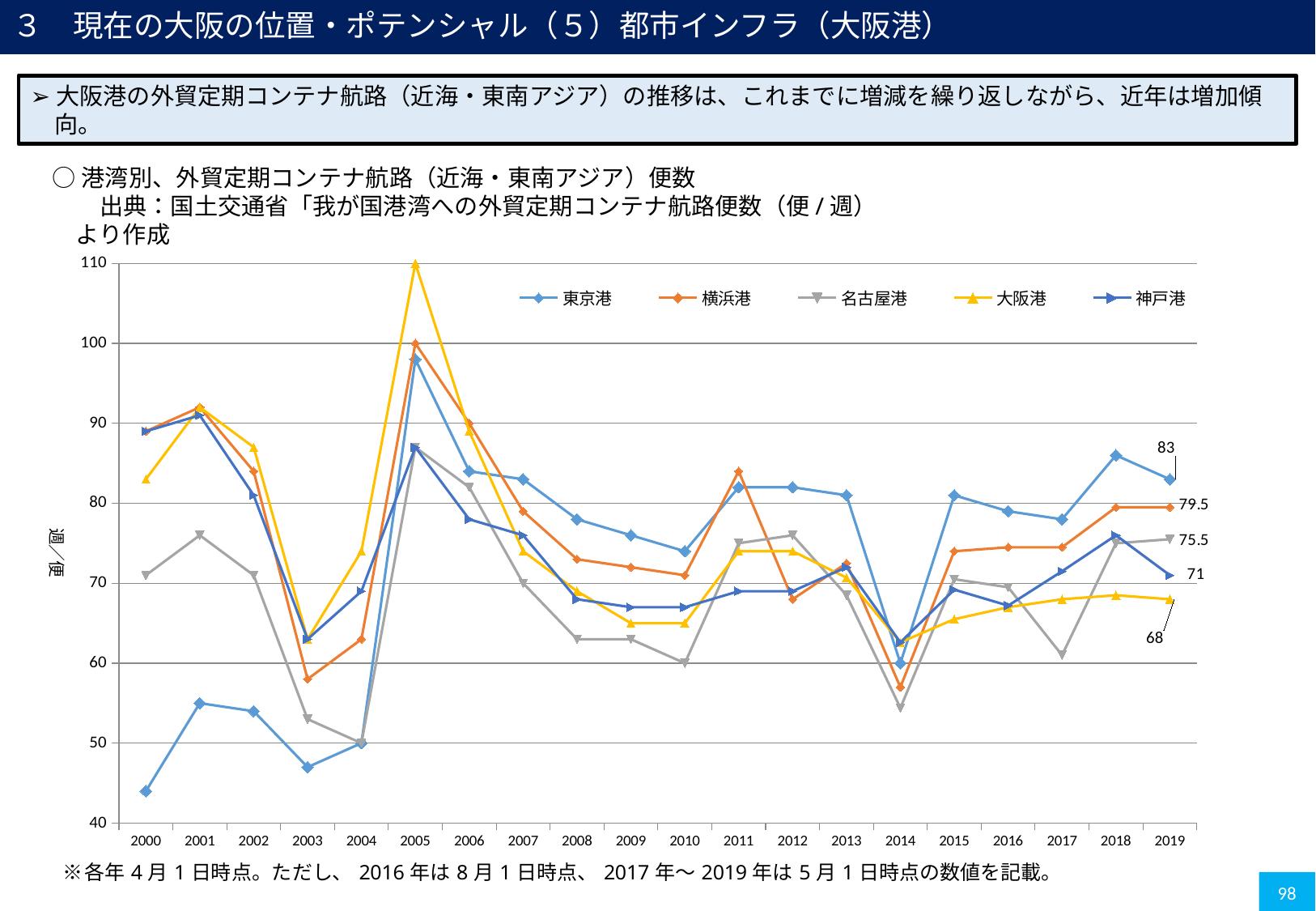
What is the difference between the 2019 values for 東京港 and 大阪港? 15 How many series does the legend list? 5 Which port has the lowest value in 2019? 大阪港 What is the value for 東京港 in 2019? 83 How many years are plotted along the x axis? 20 What is the value for 横浜港 in 2019? 79.5 What is the value for 神戸港 in 2019? 71 Is the value for 東京港 in 2000 greater or less than 50? less What is the value for 大阪港 in 2019? 68 What kind of chart is shown on the slide? line chart Is the value for 大阪港 in 2005 greater or less than 100? greater What is the value for 名古屋港 in 2019? 75.5